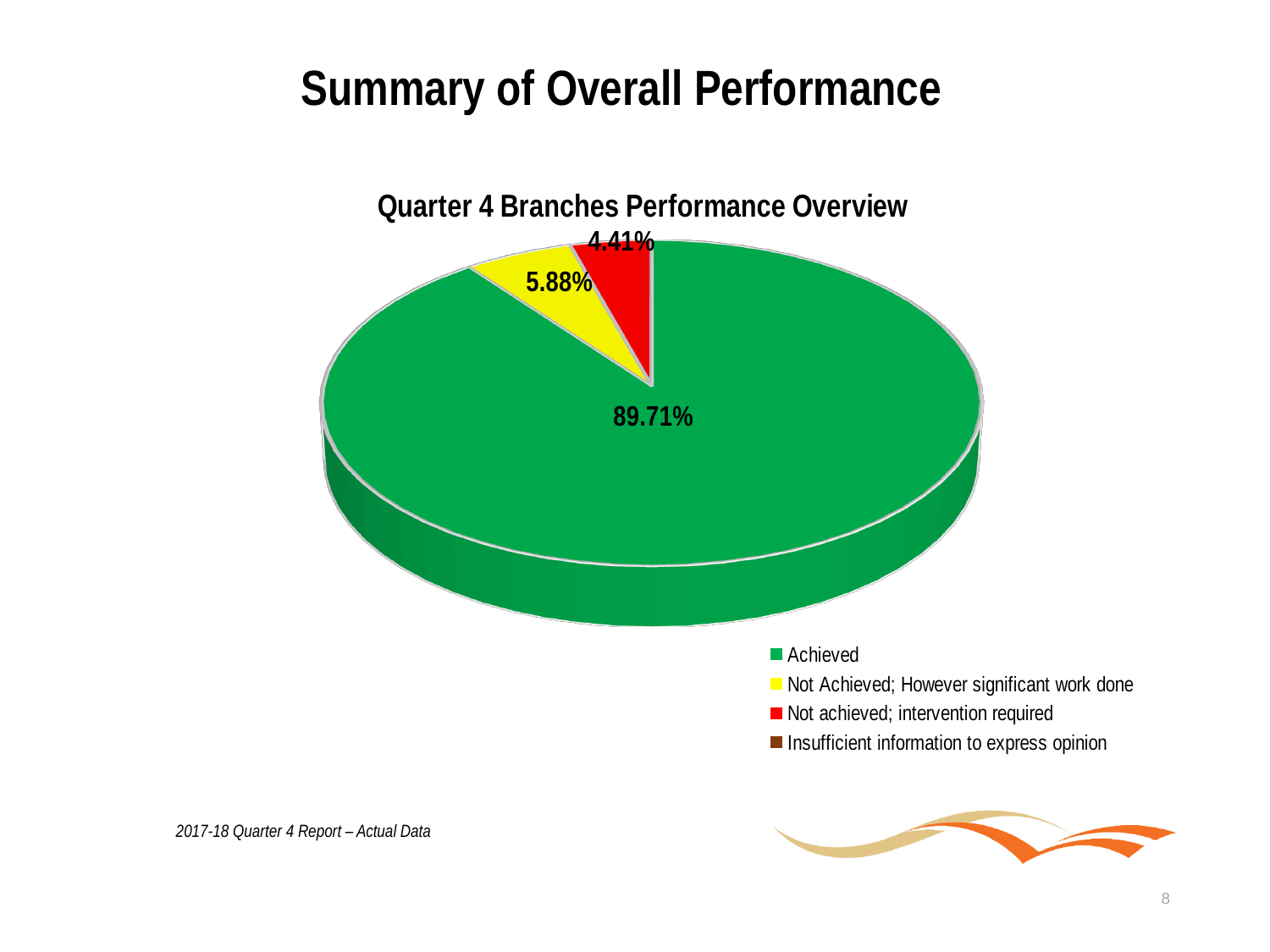
What colour represents the 'Achieved' category? green Which is larger: the share for 'Not Achieved; However significant work done' or for 'Not achieved; intervention required'? Not Achieved; However significant work done What is the difference in percentage points between 'Not Achieved; However significant work done' and 'Not achieved; intervention required'? 1.47 How many categories does the legend list? 4 Which of the labeled slices has the smallest share? Not achieved; intervention required What is the chart title? Quarter 4 Branches Performance Overview What percentage of branches are in the 'Achieved' category? 89.71% What percentage is shown for 'Not Achieved; However significant work done'? 5.88% Which category has the largest share of the pie? Achieved What is the difference in percentage points between 'Achieved' and 'Not Achieved; However significant work done'? 83.83 What percentage is shown for 'Not achieved; intervention required'? 4.41% What kind of chart is shown on the slide? pie chart